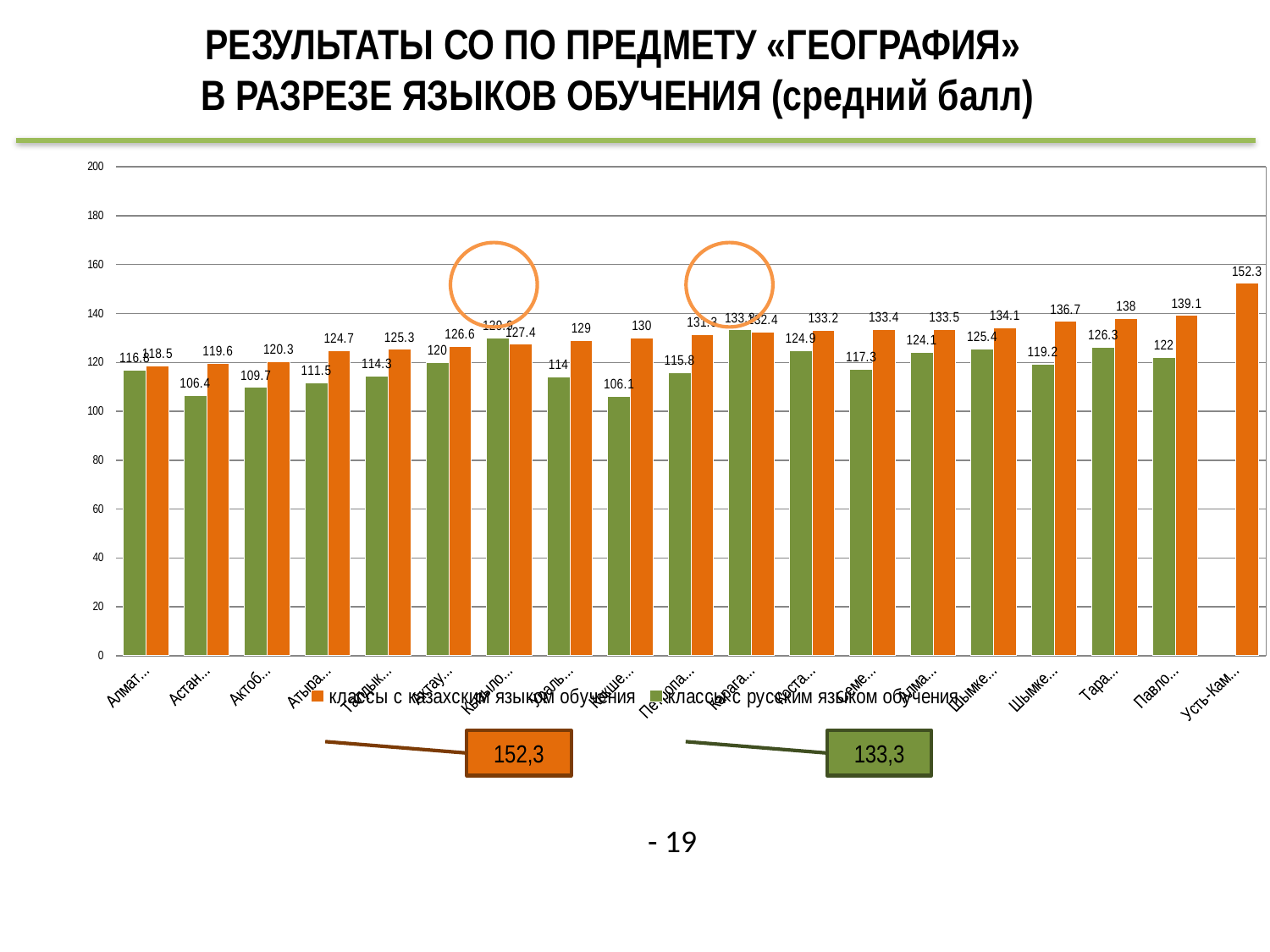
How many categories are shown along the x axis? 19 What colour represents classes with Kazakh language of instruction in the legend? orange What is the value for classes with Kazakh language of instruction (orange) in the first category, Алмат...? 118.5 What is the value for classes with Russian language of instruction (green) in the category Астан...? 106.4 Is the value for Kazakh-language classes in the category Усть-Кам... greater or less than 140? greater What is the difference between the Kazakh-language and Russian-language values in the category Астан...? 13.2 How many series does the legend list? 2 What is the highest value among the green bars (classes with Russian language of instruction)? 133.3 What is the value for classes with Kazakh language of instruction in the last category, Усть-Кам...? 152.3 In the category Актоб..., which is larger: the value for Kazakh-language classes or for Russian-language classes? Kazakh-language classes What kind of chart is shown on the slide? bar chart Which category has the highest value for classes with Kazakh language of instruction (orange)? Усть-Кам...